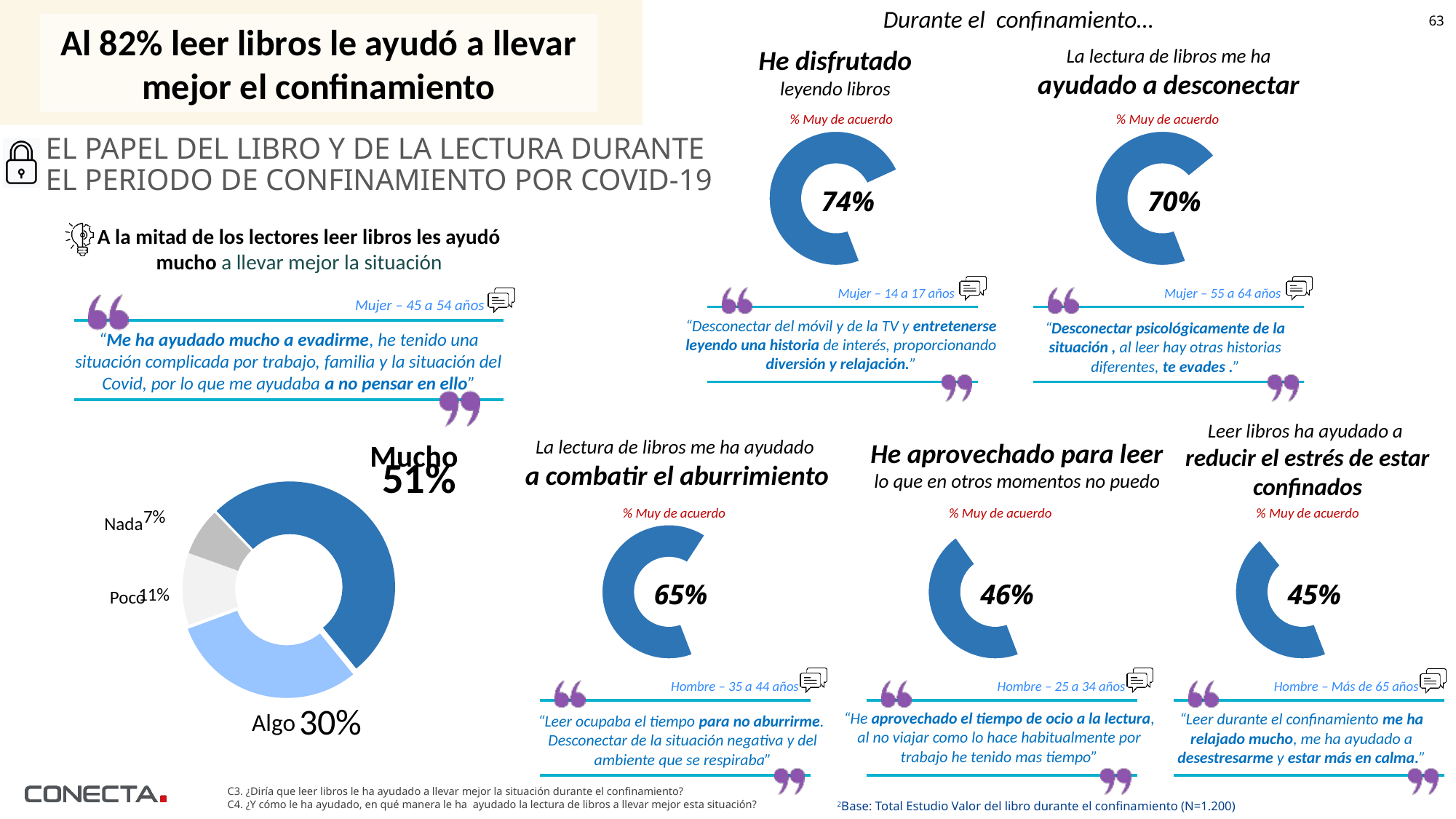
In the donut chart on the left of the slide, what percentage is shown for 'Mucho'? 51% In the donut chart on the left of the slide, how many categories are shown? 4 Which is larger: the value in the chart 'He aprovechado para leer lo que en otros momentos no puedo' or the value in the chart 'Leer libros ha ayudado a reducir el estrés de estar confinados'? He aprovechado para leer lo que en otros momentos no puedo What type of chart is used on the left of the slide to show Mucho, Algo, Poco and Nada? Donut chart In the chart titled 'He disfrutado leyendo libros', what percentage is shown as 'Muy de acuerdo'? 74% What is the difference in percentage points between the chart 'He disfrutado leyendo libros' and the chart 'La lectura de libros me ha ayudado a combatir el aburrimiento'? 9 In the donut chart on the left of the slide, what percentage is shown for 'Nada'? 7% In the chart titled 'La lectura de libros me ha ayudado a desconectar', what percentage is shown? 70% In the donut chart on the left of the slide, which category has the largest share? Mucho In the donut chart on the left of the slide, what percentage is shown for 'Algo'? 30% In the donut chart on the left of the slide, what is the difference in percentage points between 'Mucho' and 'Algo'? 21 In the donut chart on the left of the slide, which category has the smallest share? Nada